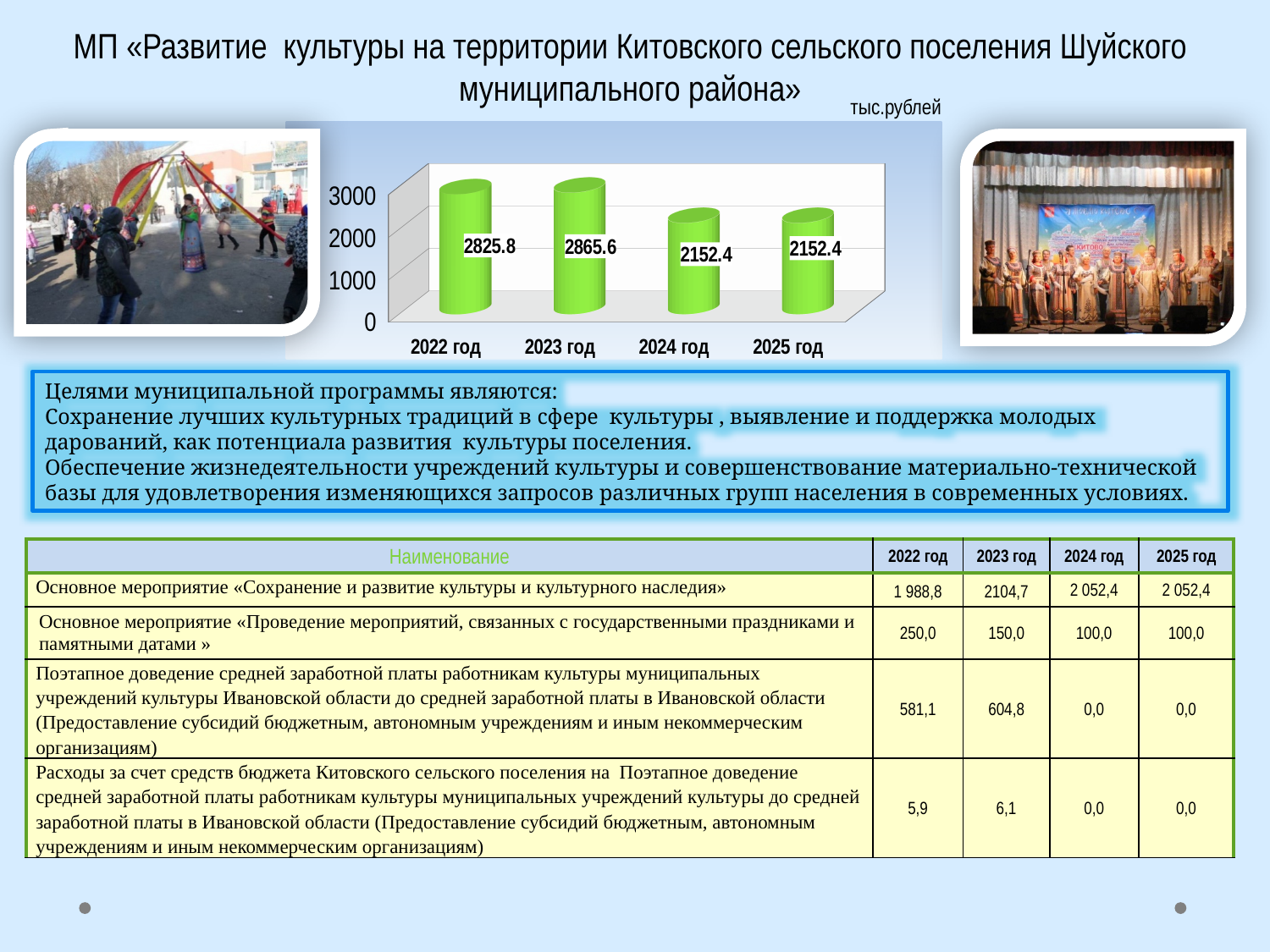
Is the value for 2024 год greater or less than 2000? greater What is the value for 2024 год in the chart? 2152.4 Which year has the highest value in the chart? 2023 год What is the value for 2022 год in the chart? 2825.8 How many years are shown on the x axis of the chart? 4 What unit is indicated above the chart? тыс.рублей Which is larger, the value for 2022 год or the value for 2025 год? 2022 год What is the value for 2023 год in the chart? 2865.6 What is the difference between the values for 2023 год and 2022 год? 39.8 What is the value for 2025 год in the chart? 2152.4 What is the difference between the values for 2022 год and 2024 год? 673.4 What kind of chart is shown on the slide? bar chart